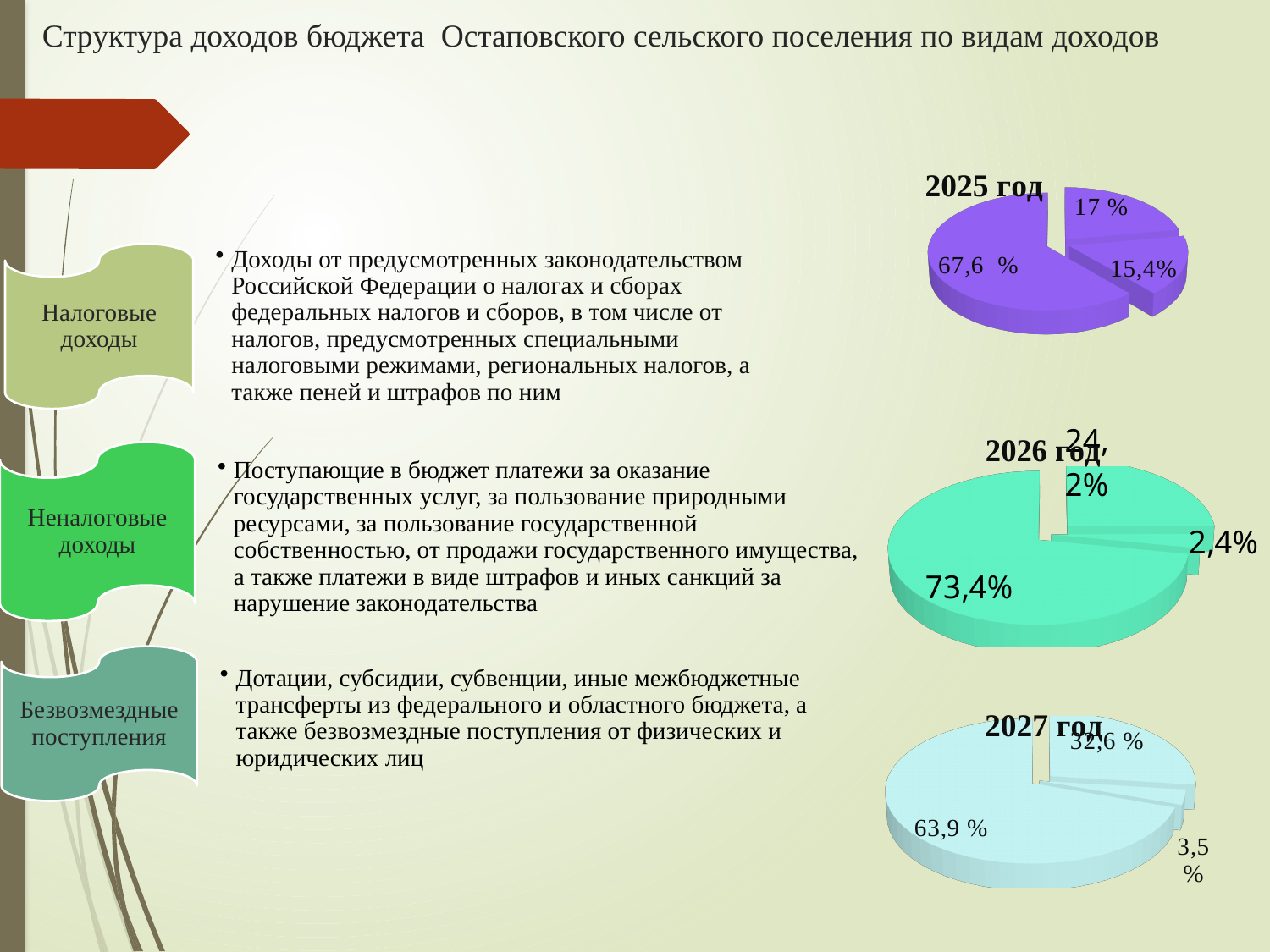
In the 2025 год pie chart, what is the difference between the 17 % slice and the 15,4% slice? 1,6 % How many pie charts are shown on the slide? 3 In the 2025 год pie chart, what is the value of the largest slice? 67,6 % In the 2026 год pie chart, what is the value of the largest slice? 73,4% How many slices does the 2025 год pie chart have? 3 In the 2026 год pie chart, what is the value of the smallest slice? 2,4% How many slices does the 2027 год pie chart have? 3 In the 2025 год pie chart, what is the value of the smallest slice? 15,4% In the 2027 год pie chart, what is the value of the smallest slice? 3,5 % What kind of chart is used for the 2025 год chart? pie chart Which is larger: the largest slice of the 2025 год chart or the largest slice of the 2027 год chart? 2025 год (67,6 %) In the 2027 год pie chart, what is the value of the largest slice? 63,9 %